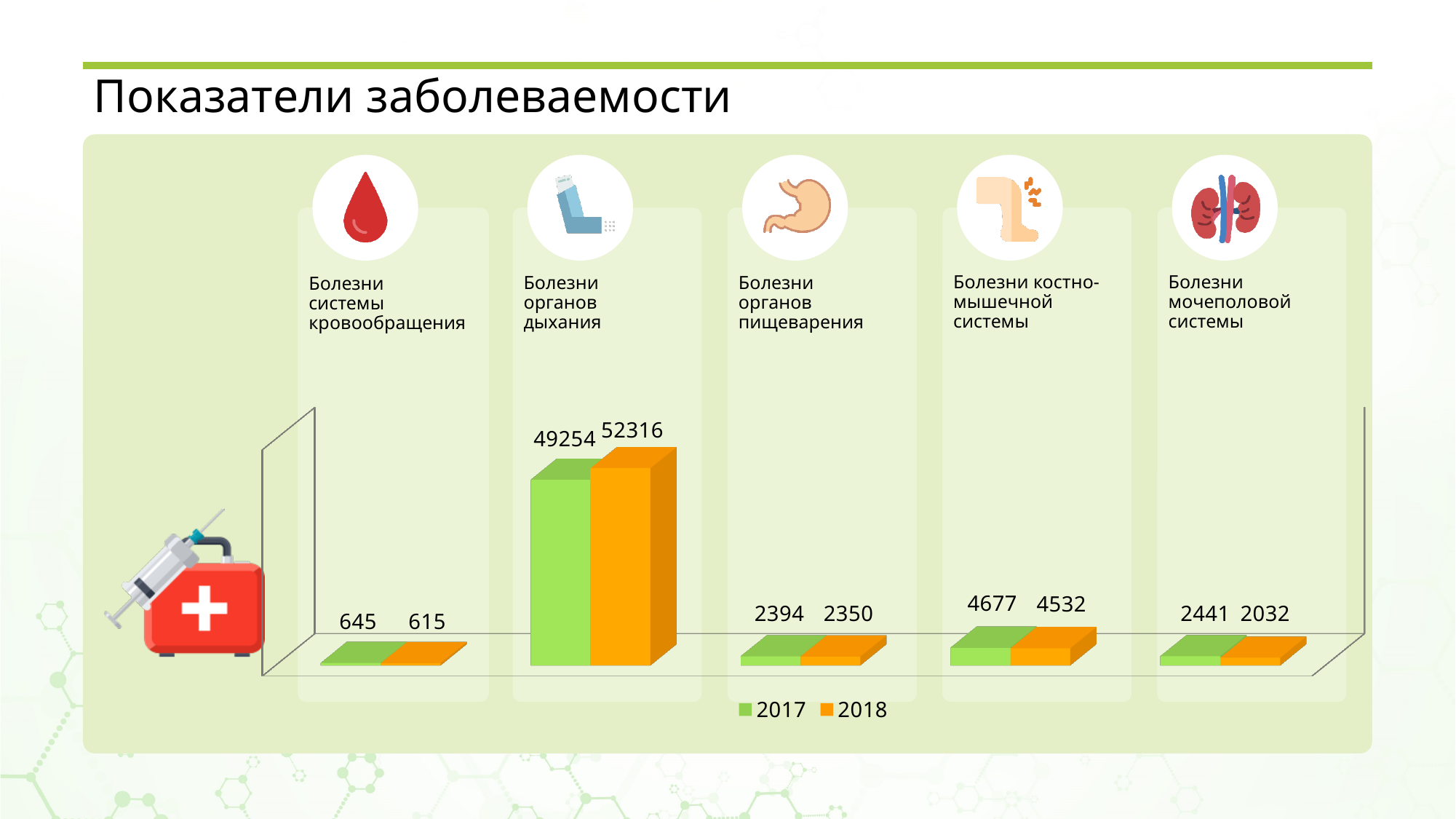
Which category has the lowest 2017 value? Болезни системы кровообращения What is the 2018 value for Болезни системы кровообращения? 615 What is the 2017 value for Болезни костно-мышечной системы? 4677 Which category has the highest 2018 value? Болезни органов дыхания Which is larger for Болезни органов пищеварения: the 2017 value or the 2018 value? 2017 What is the 2017 value for Болезни органов дыхания? 49254 What is the difference between the 2018 and 2017 values for Болезни органов дыхания? 3062 What is the 2018 value for Болезни мочеполовой системы? 2032 How many disease categories are shown in the chart? 5 How many series does the legend list? 2 What kind of chart is shown on the slide? Bar chart What is the difference between the 2017 and 2018 values for Болезни мочеполовой системы? 409